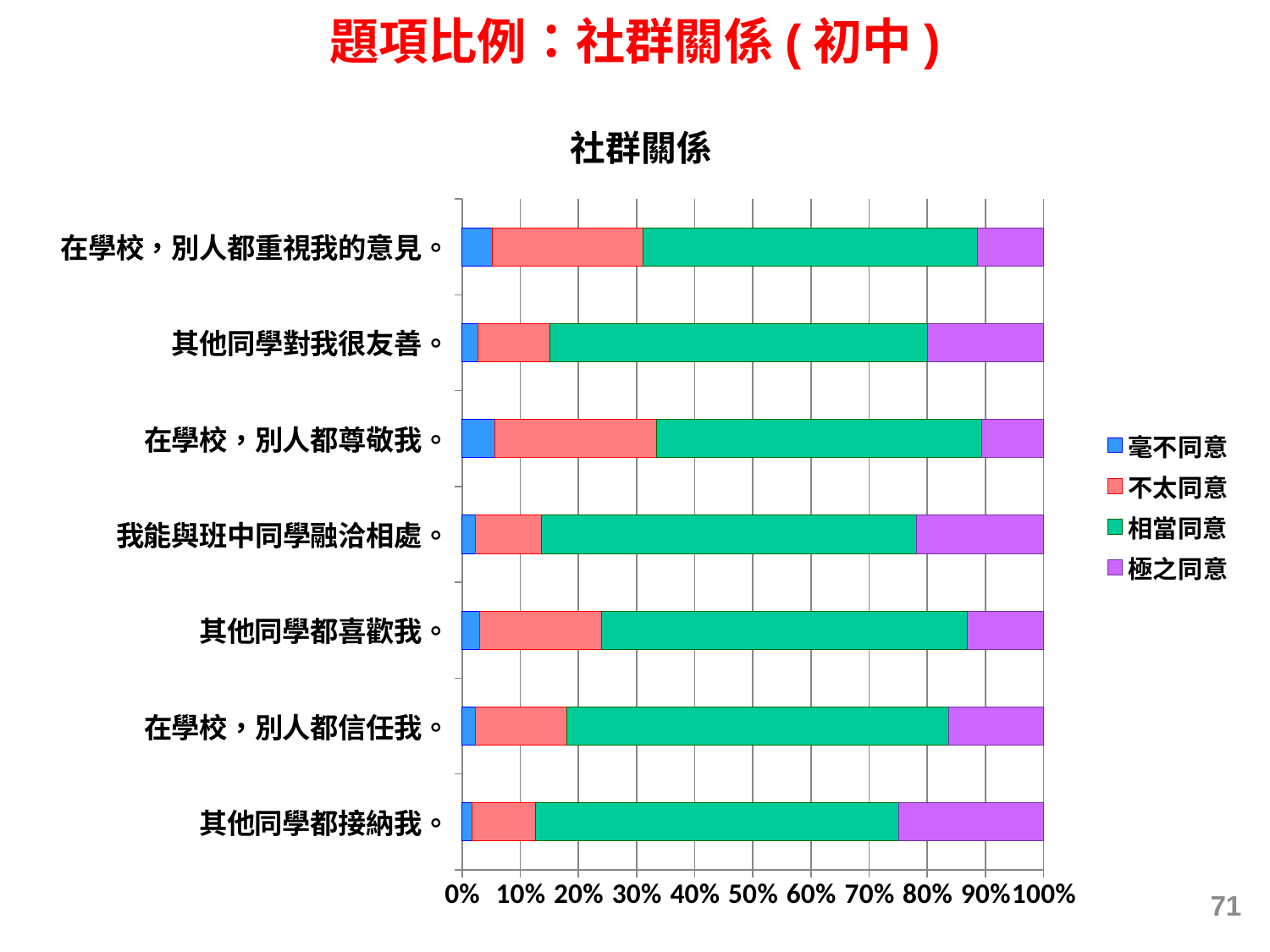
What is the total of the stacked bar for 其他同學都接納我? 100% Is the 毫不同意 value for 在學校，別人都重視我的意見 greater or less than 10%? less Is the 極之同意 value for 在學校，別人都尊敬我 greater or less than 20%? less What kind of chart is shown on the slide? stacked bar chart Which has the larger 極之同意 value: 其他同學都接納我 or 在學校，別人都尊敬我? 其他同學都接納我 Which has the larger 不太同意 value: 在學校，別人都尊敬我 or 其他同學對我很友善? 在學校，別人都尊敬我 Is the 不太同意 value for 在學校，別人都重視我的意見 greater or less than 20%? greater How many categories (statements) are plotted on the chart? 7 Which legend entry is shown in green? 相當同意 What is the title of the chart? 社群關係 How many series does the legend list? 4